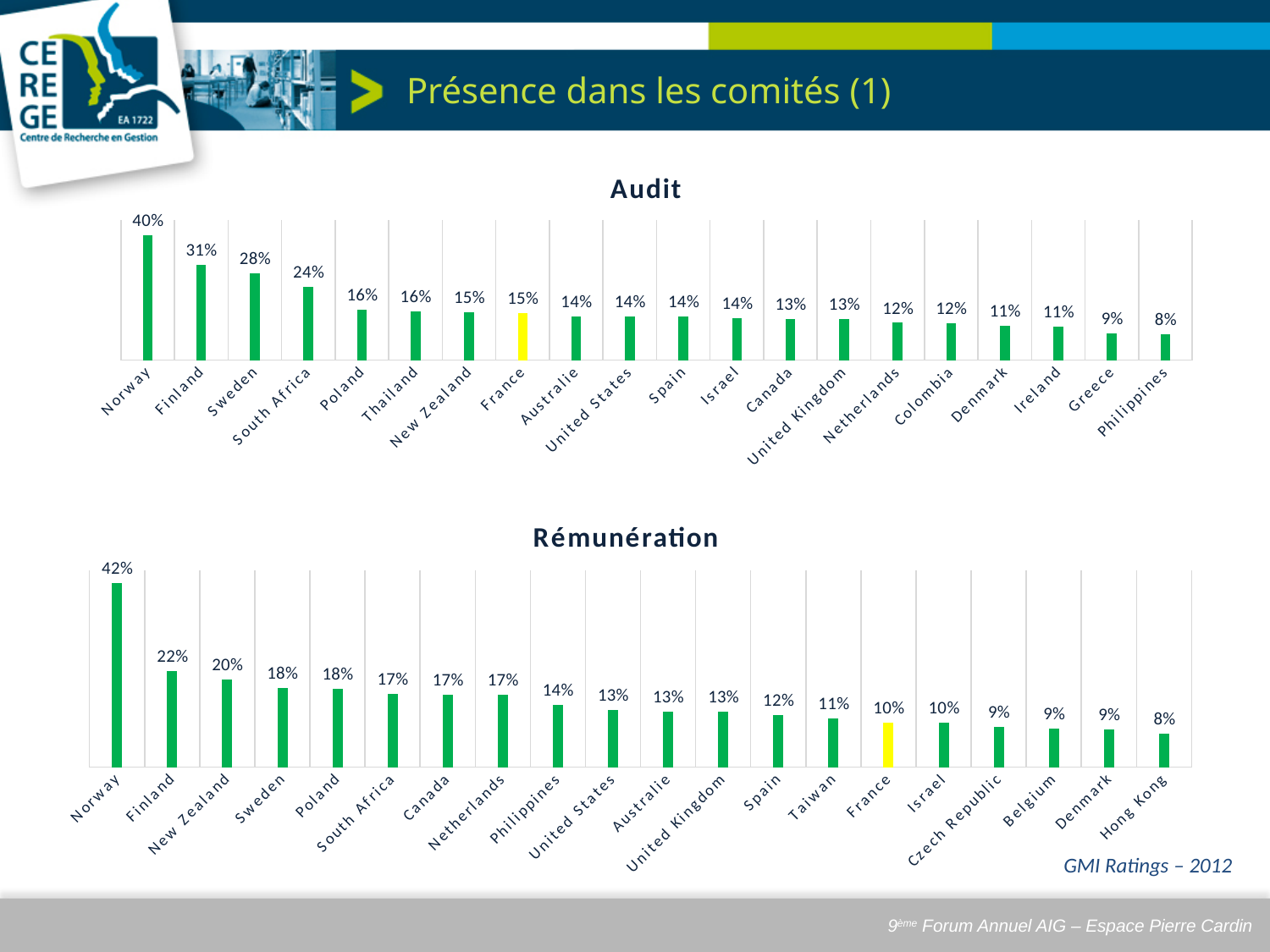
In the Rémunération chart, which is larger, the value for Finland or the value for New Zealand? Finland In the Audit chart, what is the value for France? 15% In the Audit chart, which country's bar is highlighted in yellow? France In the Audit chart, how many countries are shown? 20 In the Audit chart, what is the value for Norway? 40% In the Rémunération chart, what is the value for France? 10% In the Rémunération chart, what is the difference between Norway and Hong Kong? 34% In the Audit chart, which country has the lowest value? Philippines In the Rémunération chart, what is the value for Norway? 42% What type of chart is the Audit chart? Bar chart In the Audit chart, what is the difference between Norway and Finland? 9% In the Rémunération chart, which country has the highest value? Norway